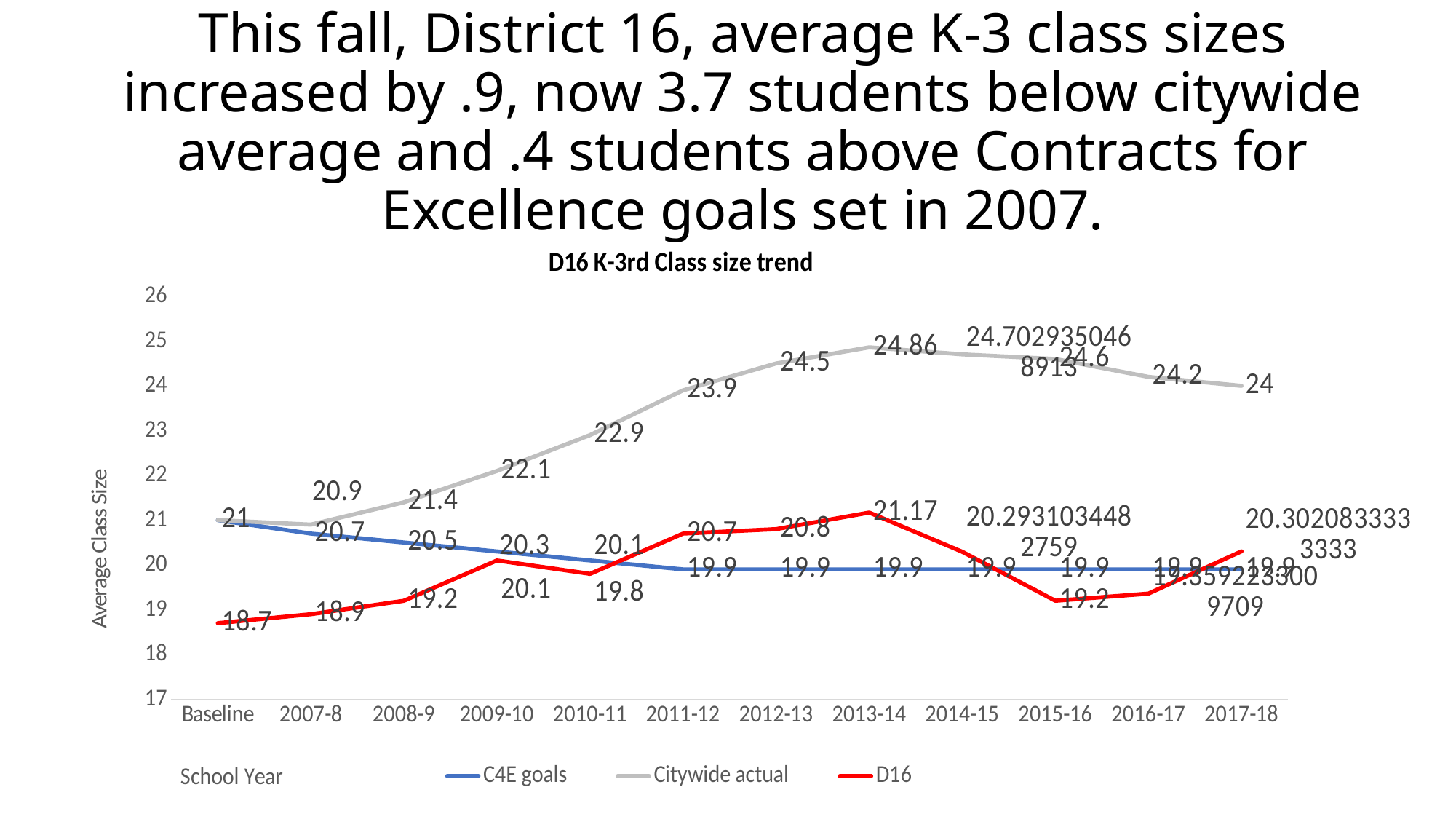
How many school-year points are plotted along the x axis? 12 What is the D16 value for 2013-14? 21.17 What is the Citywide actual value for 2017-18? 24 Which is larger in 2011-12, the Citywide actual value or the D16 value? Citywide actual Does the Citywide actual series rise or fall from Baseline to 2013-14? Rise What is the D16 value at Baseline? 18.7 How many series does the legend list? 3 In which school year is the D16 series at its lowest value? Baseline What is the Citywide actual value for 2013-14? 24.86 In which school year does the Citywide actual series reach its highest value? 2013-14 What is the difference between the Citywide actual and D16 values in 2013-14? 3.69 What type of chart is shown on the slide? Line chart